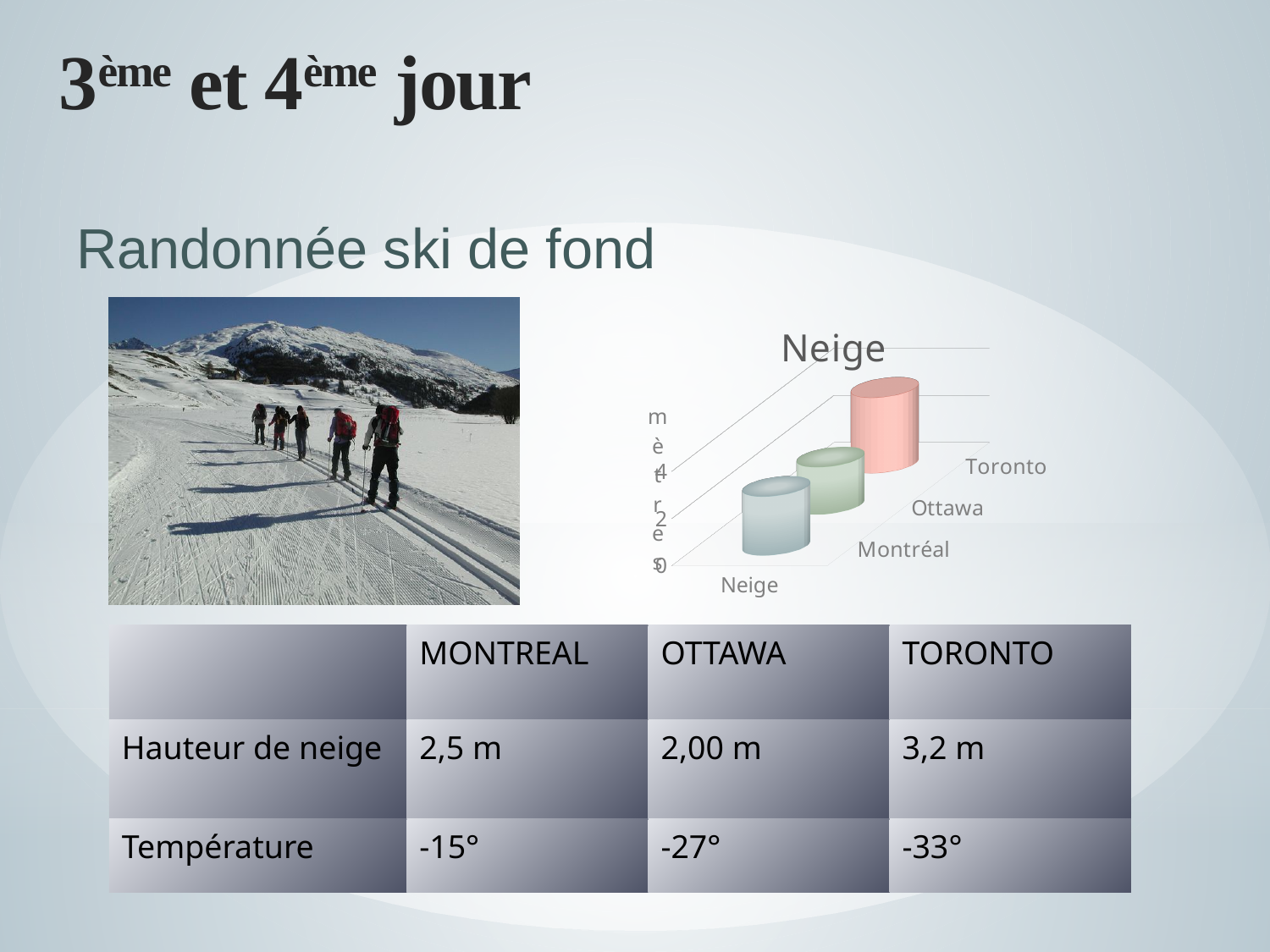
In the Neige chart, which is larger, the value for Toronto or the value for Ottawa? Toronto In the Neige chart, is the value for Toronto greater or less than 2? greater In the Neige chart, is the value for Toronto greater or less than 4? less Which category has the highest value in the Neige chart? Toronto What is the highest tick value shown on the vertical axis of the Neige chart? 4 What kind of chart is shown on the slide? bar chart What is the label of the vertical axis of the Neige chart? mètres In the Neige chart, which is larger, the value for Toronto or the value for Montréal? Toronto What is the title of the chart? Neige How many categories are plotted in the Neige chart? 1